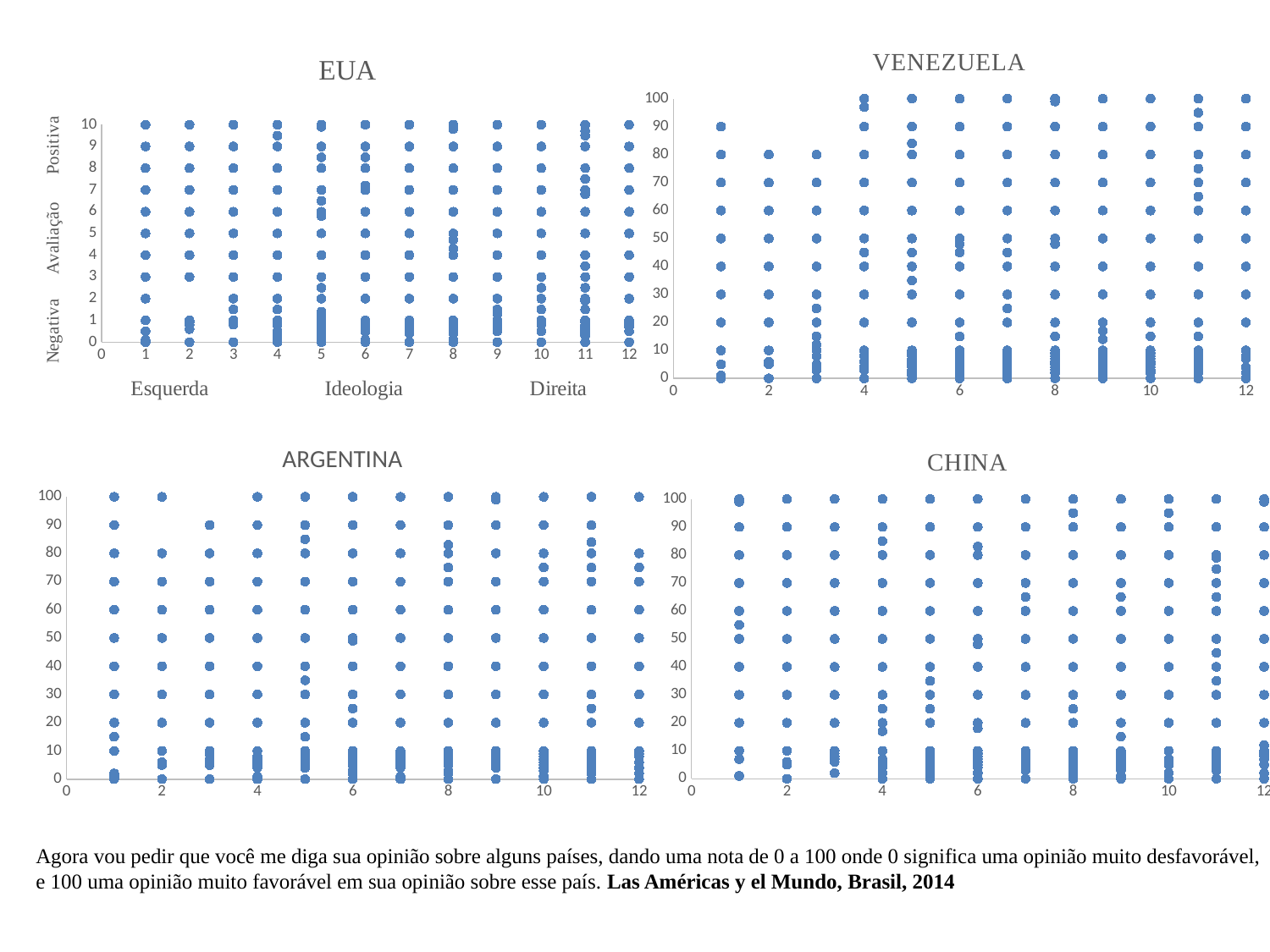
What kind of chart is the CHINA chart? scatter chart How many charts are shown on the slide? 4 In the VENEZUELA chart, is the highest point at x = 2 greater or less than 90? less What is the highest value shown on the y axis of the EUA chart? 10 In the EUA chart, what label is shown at the right end of the x axis? Direita What are the titles of the four charts on the slide? EUA, VENEZUELA, ARGENTINA, CHINA What is the highest value shown on the y axis of the VENEZUELA chart? 100 What is the highest value shown on the x axis of the ARGENTINA chart? 12 In the VENEZUELA chart, is the highest point at x = 3 greater or less than 90? less How many tick labels are shown on the x axis of the EUA chart? 13 In the EUA chart, what label is shown at the left end of the x axis? Esquerda What kind of chart is the EUA chart? scatter chart